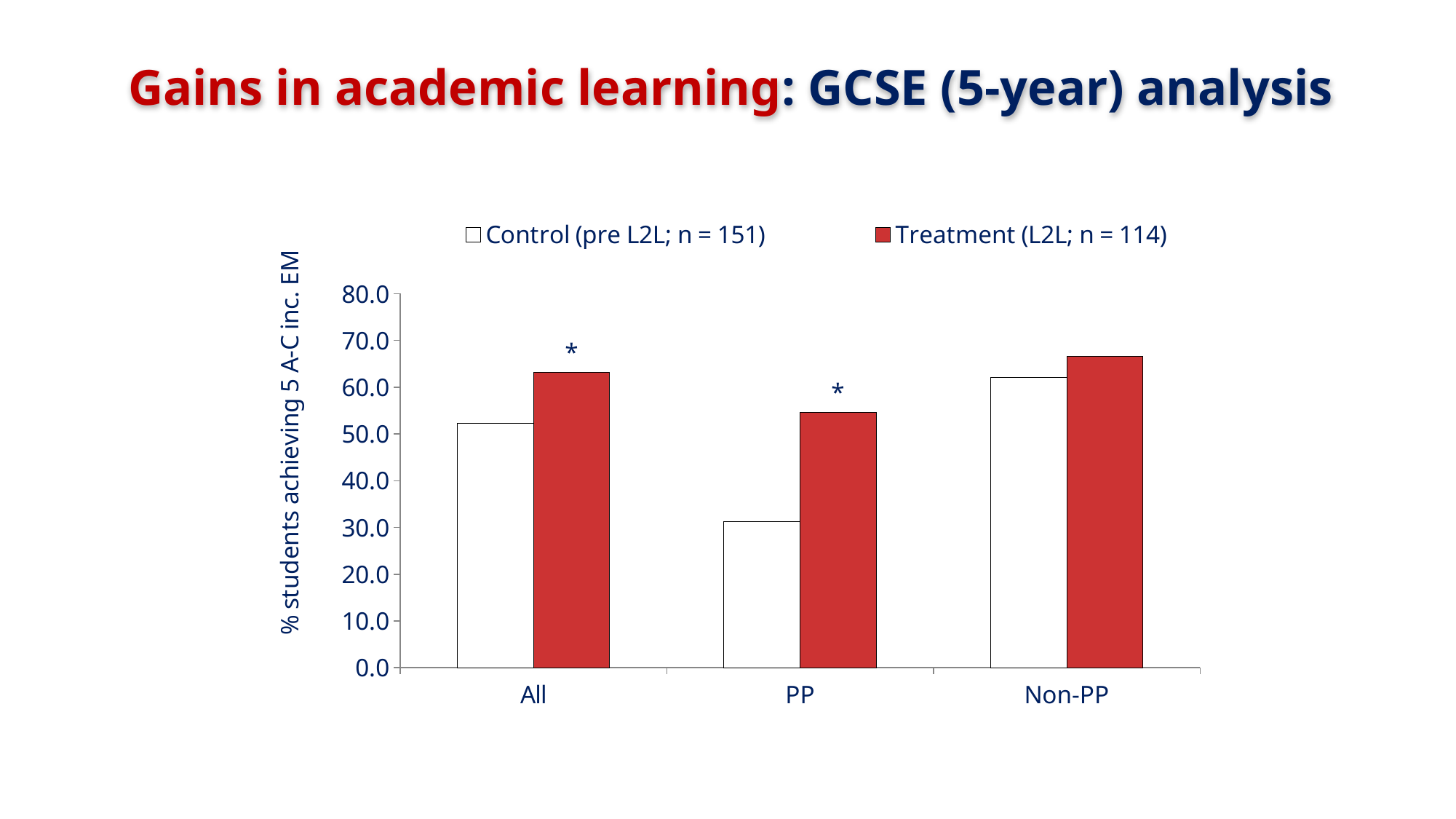
How many categories are shown on the x axis of the chart? 3 Which category has the highest Treatment (L2L; n = 114) bar? Non-PP What kind of chart is shown on the slide? bar chart What is the label on the vertical axis of the chart? % students achieving 5 A-C inc. EM Is the Treatment (L2L; n = 114) value for PP greater or less than 50.0? greater Is the Control (pre L2L; n = 151) value for PP greater or less than 40.0? less Which category has the lowest Control (pre L2L; n = 151) bar? PP Which is larger: the Control bar for All or the Control bar for Non-PP? Non-PP For the PP category, which is larger: the Control bar or the Treatment bar? Treatment Is the Control (pre L2L; n = 151) value for All greater or less than 60.0? less How many series does the chart's legend list? 2